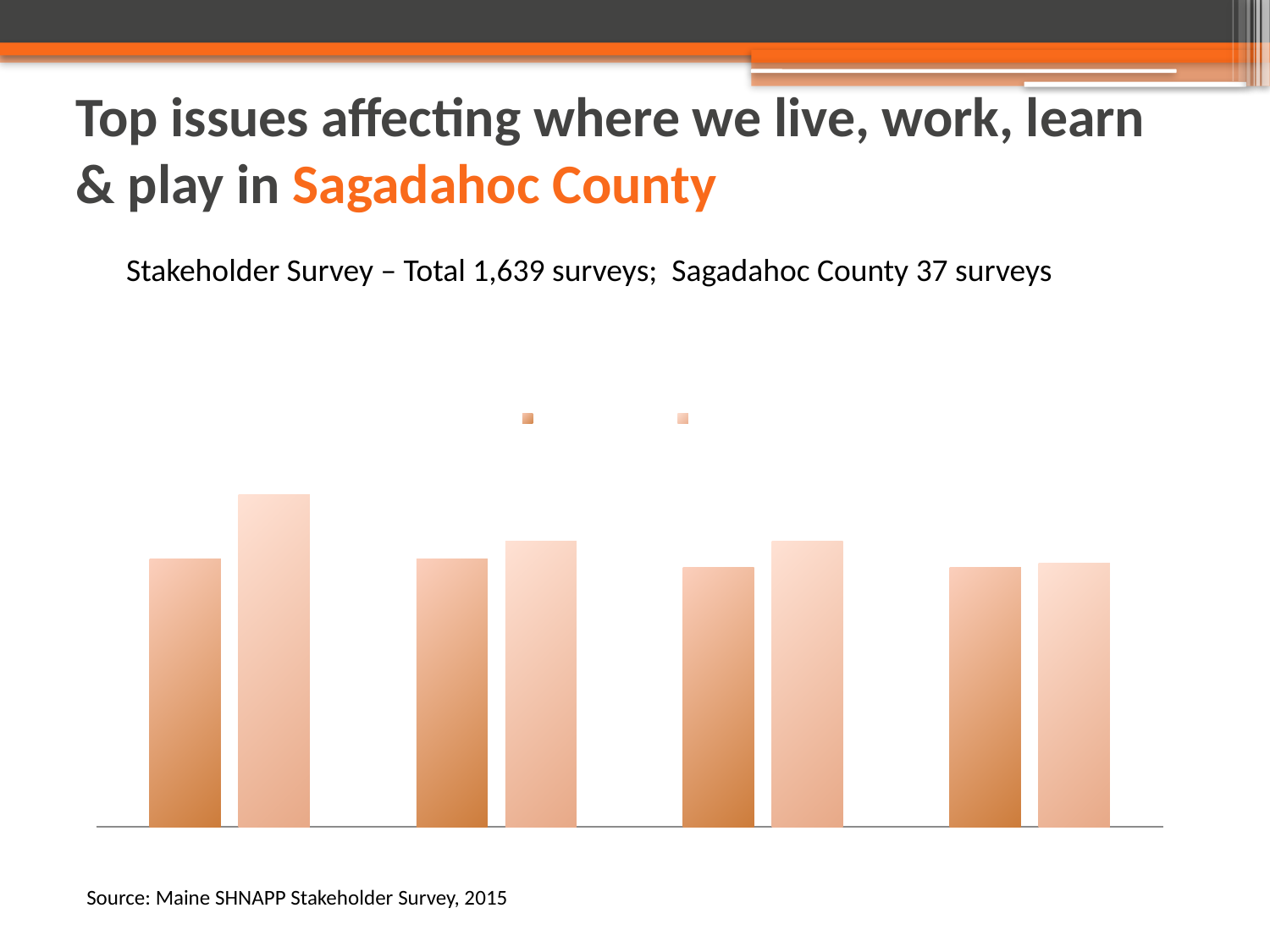
In the first group of bars from the left, is the lighter bar taller or shorter than the darker bar? taller How many series does the chart's legend show? 2 What colour family are the bars on the chart? orange Which group of bars, counted from the left, contains the tallest bar on the chart? the first How many groups of bars are plotted on the chart? 4 What kind of chart is shown on the slide? bar chart Are the bars on the chart vertical or horizontal? vertical In each group of bars, is the lighter bar taller or shorter than the darker bar? taller How many bars are plotted in total on the chart? 8